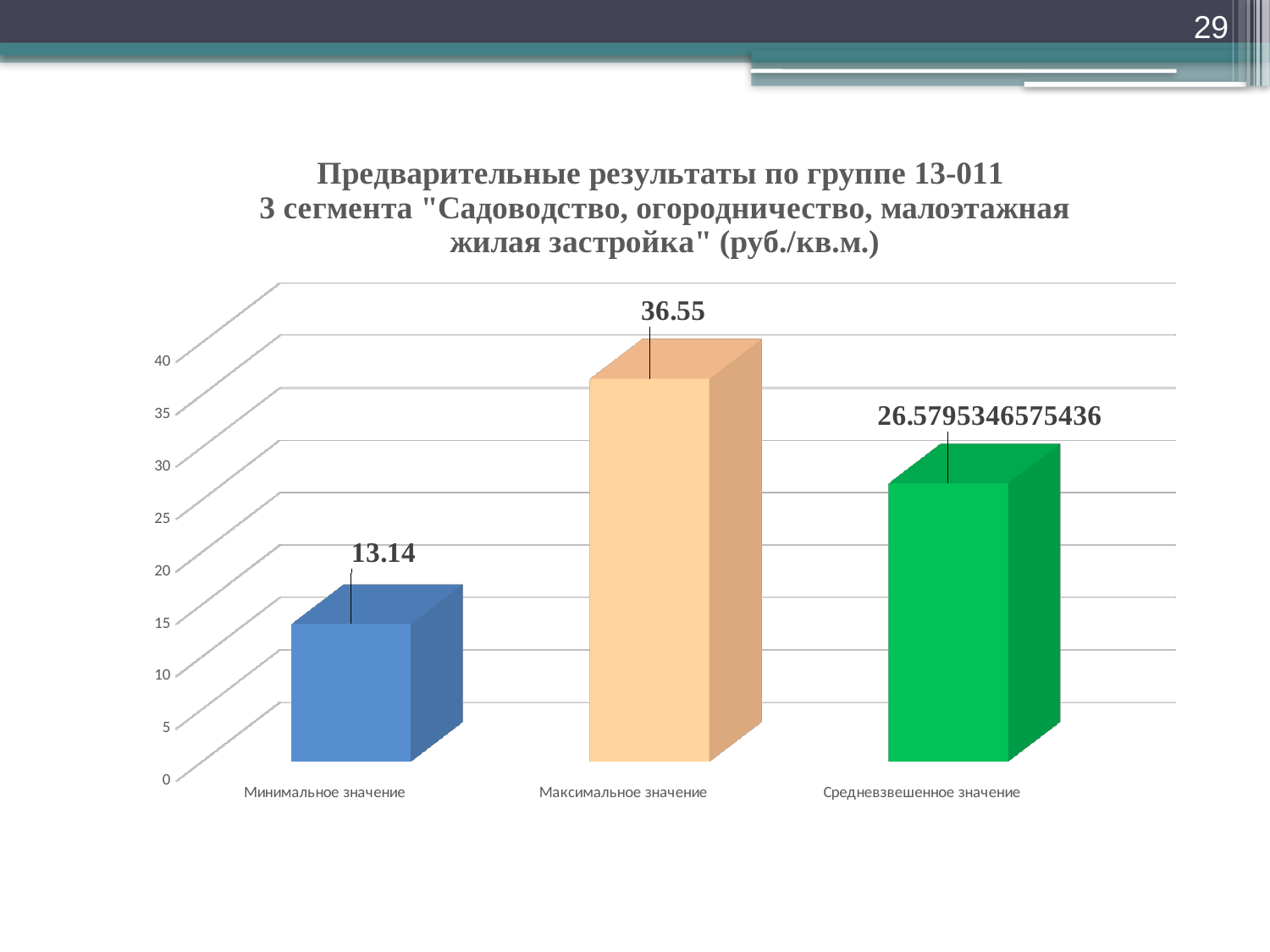
What kind of chart is shown on the slide? bar chart Is the value for Минимальное значение greater or less than 15? less Which is larger, the value for Средневзвешенное значение or the value for Минимальное значение? Средневзвешенное значение What colour is the bar for Максимальное значение? orange Is the value for Средневзвешенное значение greater or less than 25? greater How many categories are shown on the chart? 3 What is the difference between the values for Максимальное значение and Минимальное значение? 23.41 What is the value for Максимальное значение? 36.55 Which category has the lowest value? Минимальное значение Which category has the highest value? Максимальное значение What is the value for Минимальное значение? 13.14 What is the value for Средневзвешенное значение? 26.5795346575436